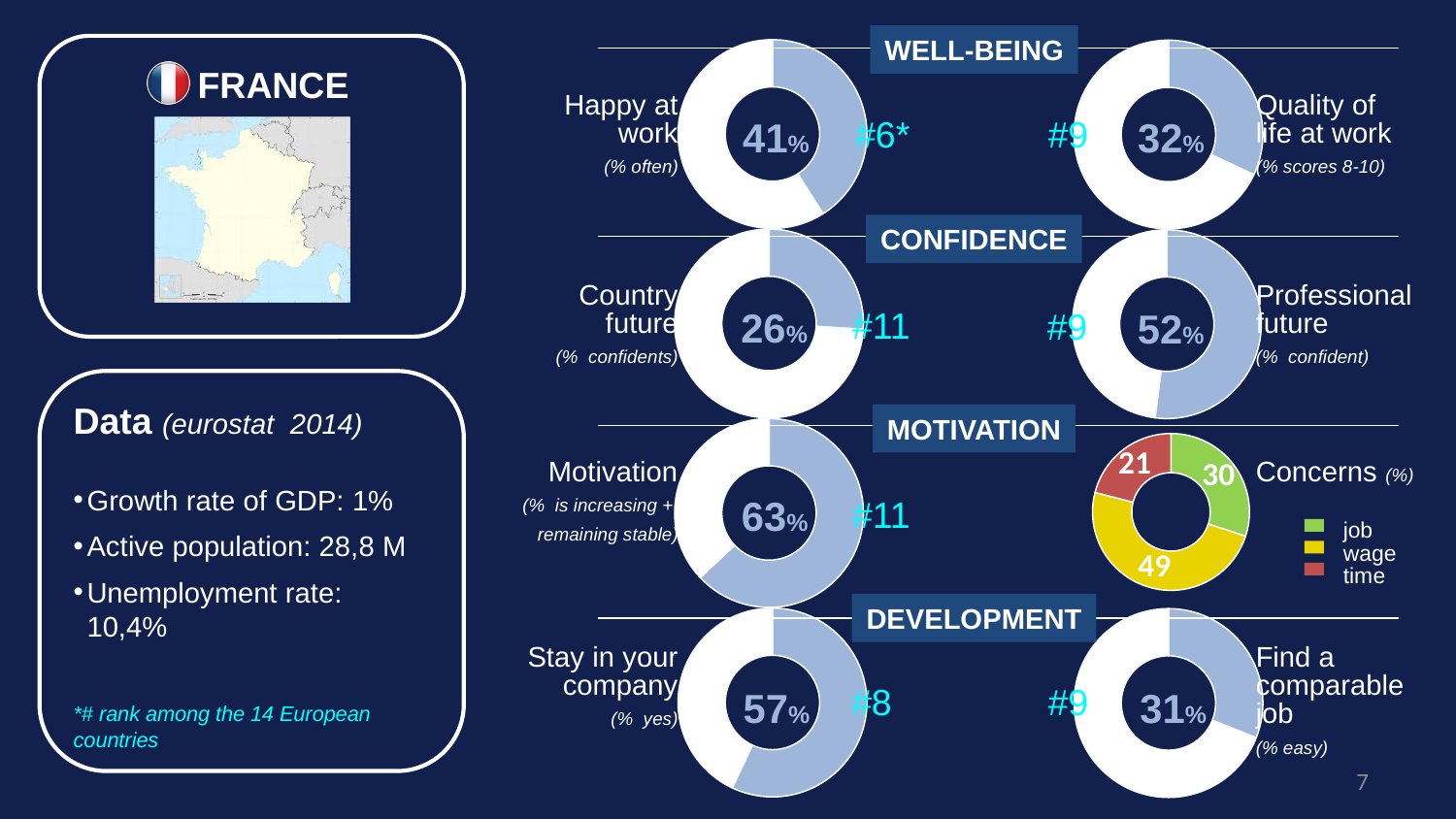
In the "Motivation" donut chart, what percentage is displayed? 63% In the "Professional future" donut chart, what value is shown? 52% In the "Country future" donut chart, what percentage of respondents are confident? 26% In the "Concerns" pie chart, what is the value for wage? 49 In the "Concerns" pie chart, which category has the largest value? wage Which is larger: the value in the "Stay in your company" donut chart or the value in the "Find a comparable job" donut chart? Stay in your company In the "Quality of life at work" donut chart, what value is displayed? 32% In the "Concerns" pie chart, how many categories does the legend list? 3 What type of chart is used for "Stay in your company"? Donut chart In the "Concerns" pie chart, what is the difference between the wage value and the job value? 19 In the "Happy at work" donut chart, what percentage is shown in the centre? 41% In the "Concerns" pie chart, which category has the smallest value? time